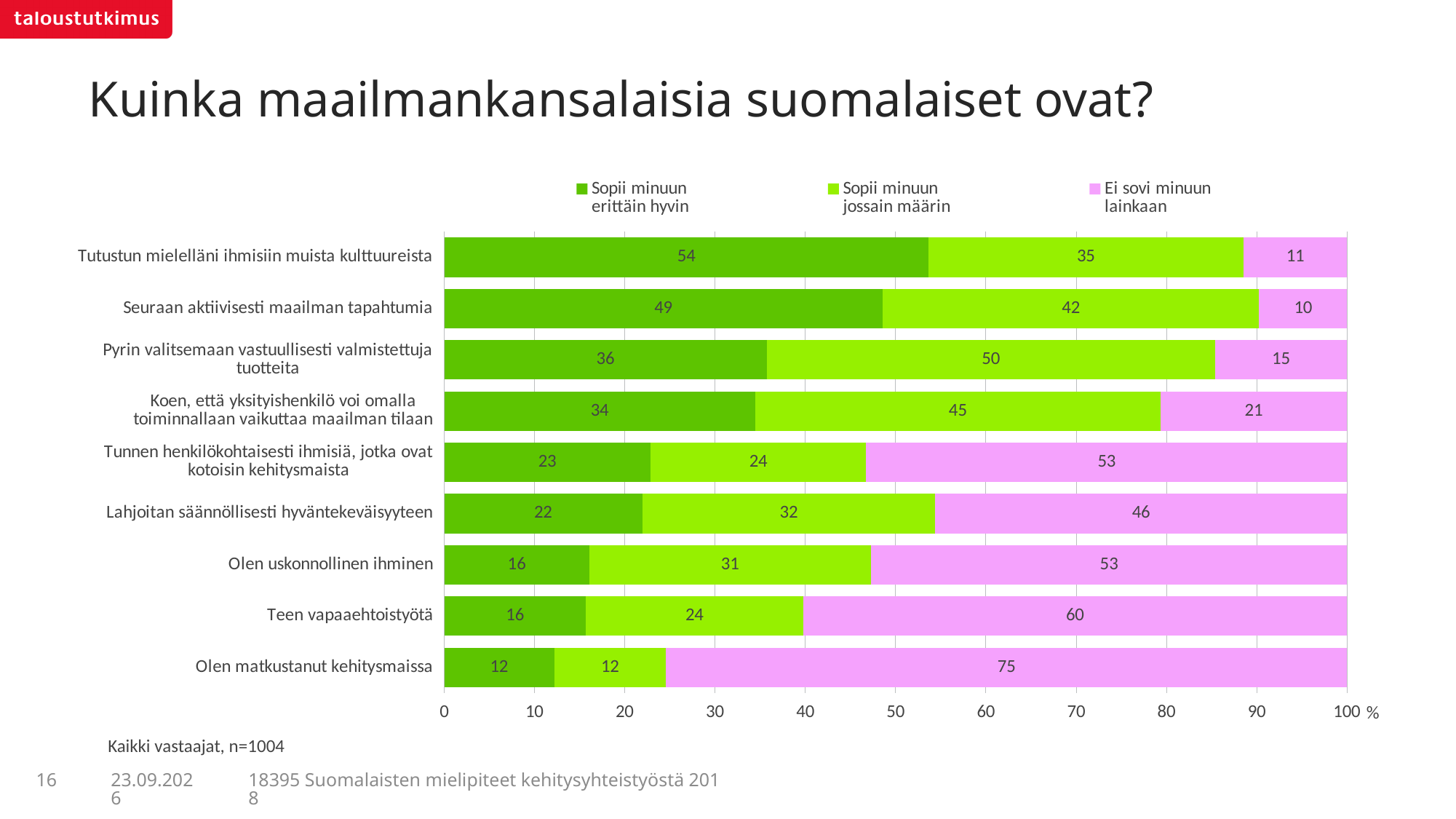
What is the total of the stacked bar for "Koen, että yksityishenkilö voi omalla toiminnallaan vaikuttaa maailman tilaan"? 100 How many series does the legend list? 3 What is the value of "Ei sovi minuun lainkaan" for "Olen matkustanut kehitysmaissa"? 75 Which category has the highest value for "Ei sovi minuun lainkaan"? Olen matkustanut kehitysmaissa What is the difference between the "Ei sovi minuun lainkaan" values for "Teen vapaaehtoistyötä" and "Lahjoitan säännöllisesti hyväntekeväisyyteen"? 14 What kind of chart is shown on the slide? Stacked bar chart How many categories are shown in the chart? 9 Which is larger: the "Sopii minuun erittäin hyvin" value for "Seuraan aktiivisesti maailman tapahtumia" or for "Pyrin valitsemaan vastuullisesti valmistettuja tuotteita"? Seuraan aktiivisesti maailman tapahtumia What is the title of the chart? Kuinka maailmankansalaisia suomalaiset ovat? What is the value of "Sopii minuun erittäin hyvin" for "Tutustun mielelläni ihmisiin muista kulttuureista"? 54 What is the value of "Sopii minuun jossain määrin" for "Pyrin valitsemaan vastuullisesti valmistettuja tuotteita"? 50 Which category has the lowest value for "Sopii minuun erittäin hyvin"? Olen matkustanut kehitysmaissa